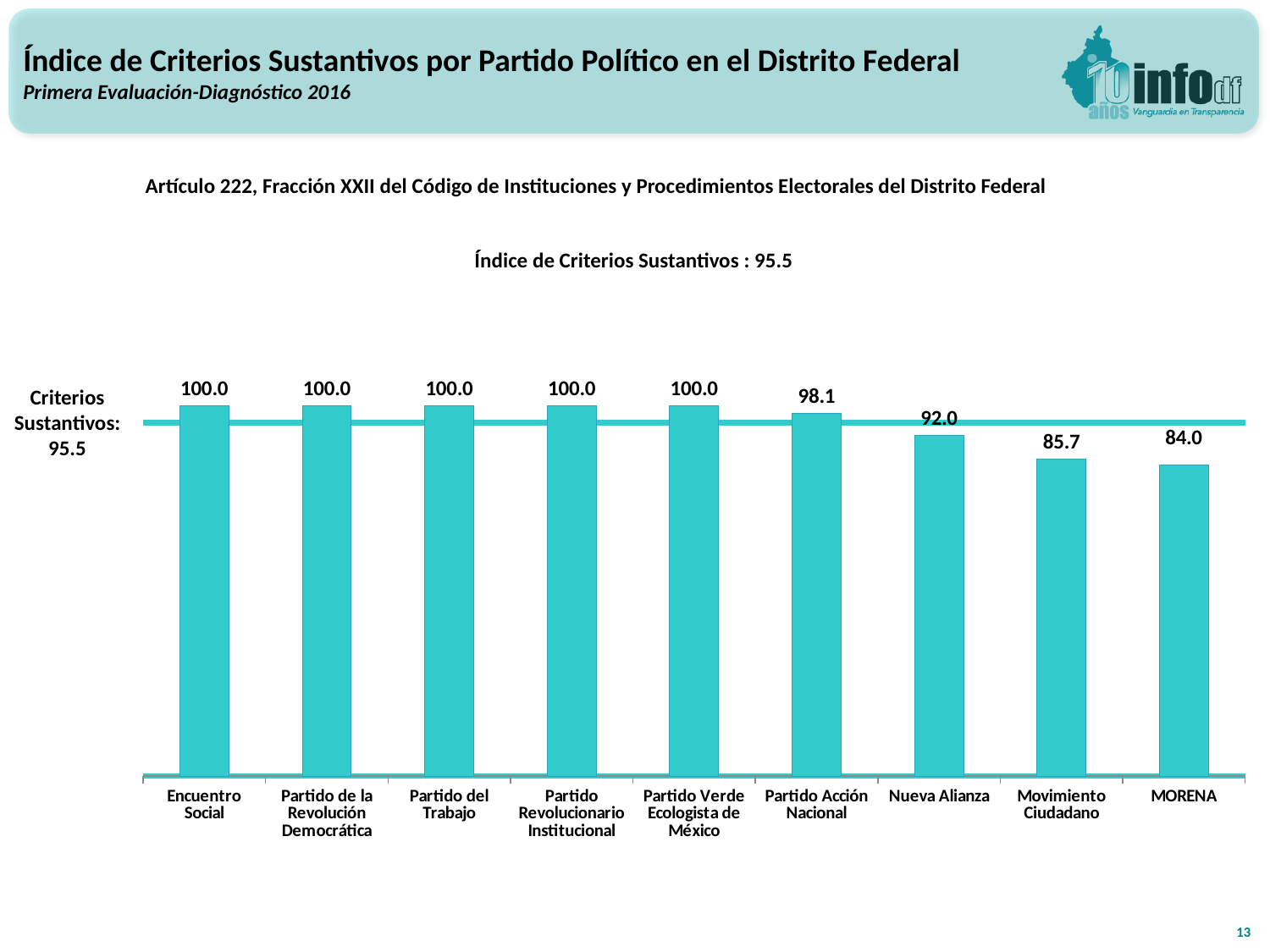
Which category has the lowest value? MORENA Do the values rise or fall from left to right along the x axis? Fall How many categories are shown in the chart? 9 What is the value for Movimiento Ciudadano? 85.7 What is the value for Partido Acción Nacional? 98.1 Which is larger, the value for Nueva Alianza or the value for Movimiento Ciudadano? Nueva Alianza What kind of chart is shown on the slide? Bar chart What is the value for Nueva Alianza? 92.0 What is the difference between the values for Encuentro Social and MORENA? 16.0 What value does the horizontal reference line labelled Criterios Sustantivos represent? 95.5 What is the value for MORENA? 84.0 What is the difference between the values for Partido Acción Nacional and Nueva Alianza? 6.1